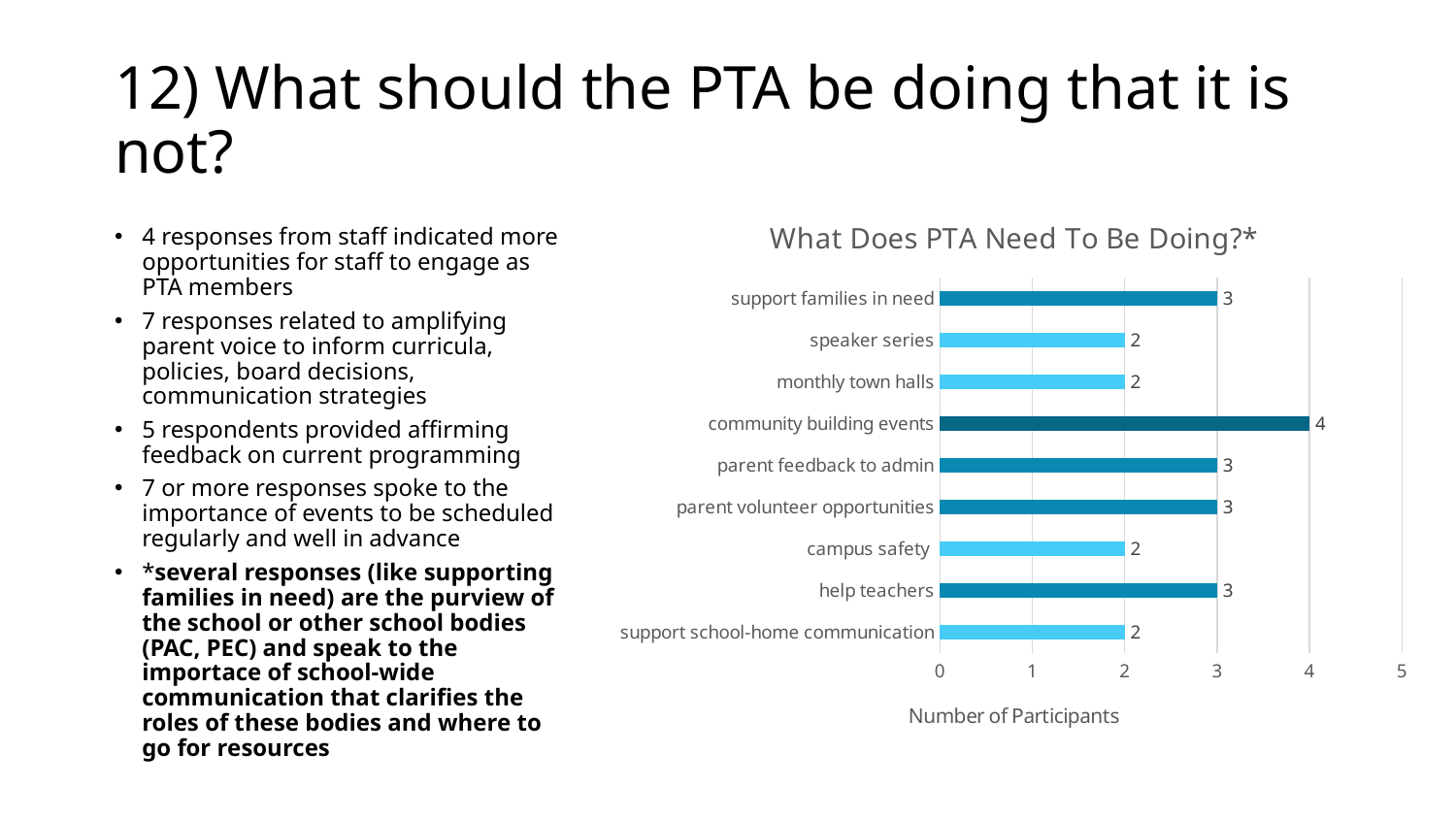
What is the value for campus safety? 2 What is the difference between the values for community building events and speaker series? 2 What is the difference between the values for parent volunteer opportunities and support school-home communication? 1 What is the label of the horizontal axis? Number of Participants Which category has the highest value? community building events What kind of chart is this? bar chart What is the value for help teachers? 3 What is the value for support families in need? 3 Which is larger, the value for parent feedback to admin or the value for monthly town halls? parent feedback to admin What is the value for community building events? 4 How many categories are shown in the chart? 9 What is the title of the chart? What Does PTA Need To Be Doing?*